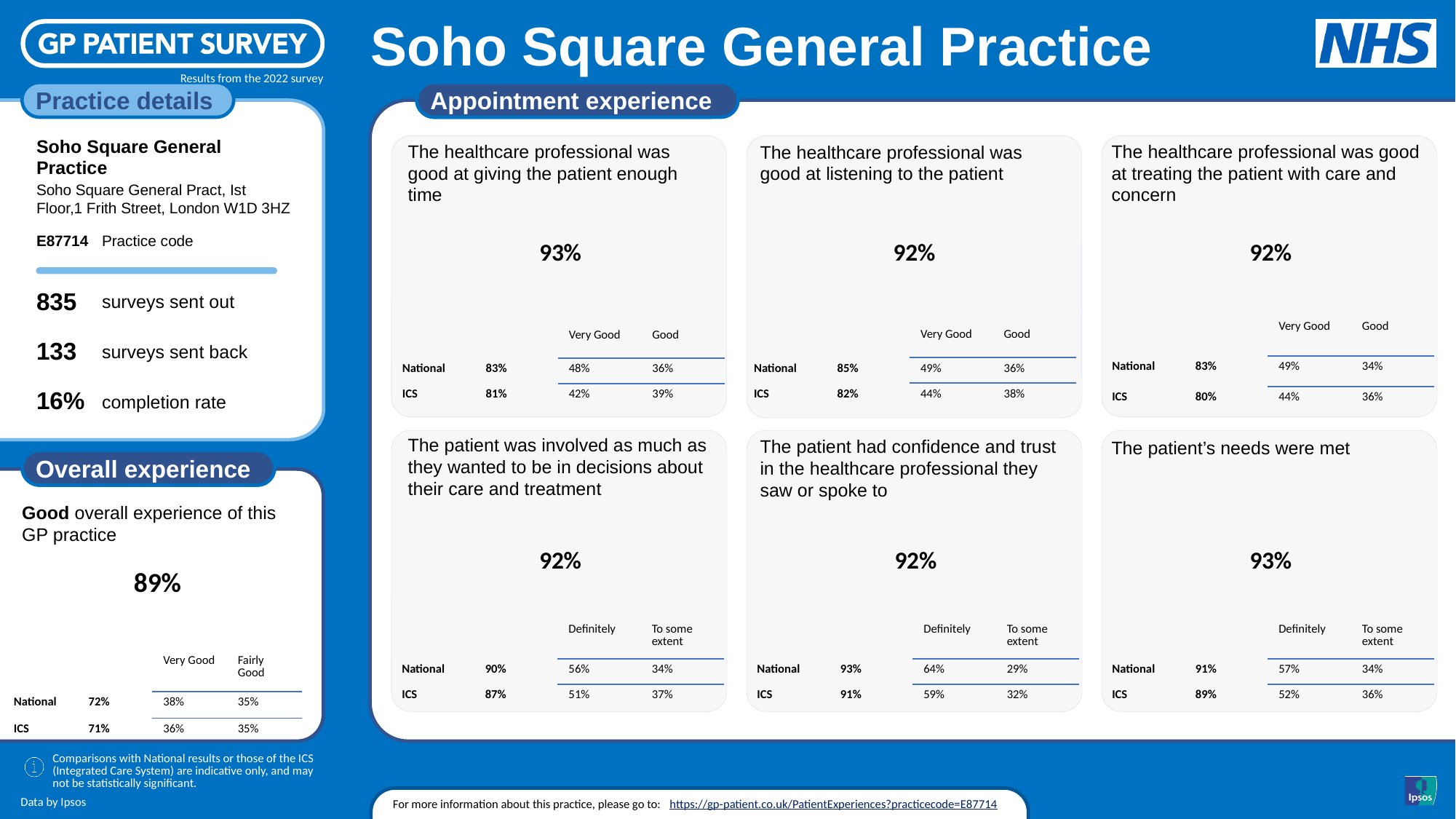
In the 'Overall experience' panel, what percentage of patients reported a good overall experience of this GP practice? 89% In the panel 'The patient's needs were met', what is the difference between the National figure (91%) and the ICS figure (89%)? 2 percentage points In the panel 'The healthcare professional was good at treating the patient with care and concern', what is the ICS overall figure? 80% In the panel 'The patient had confidence and trust in the healthcare professional they saw or spoke to', which is larger: the National 'Definitely' percentage or the ICS 'Definitely' percentage? National (64%) In the panel 'The patient was involved as much as they wanted to be in decisions about their care and treatment', what is the difference between the practice's 92% and the National 90%? 2 percentage points In the panel 'The healthcare professional was good at giving the patient enough time', what is the practice's headline percentage? 93% How many question panels are shown under the 'Appointment experience' heading? 6 In the panel 'The healthcare professional was good at listening to the patient', what is the National 'Very Good' percentage? 49% In the panel 'The patient's needs were met', what is the ICS 'To some extent' percentage? 36% In the 'Overall experience' panel, what is the ICS 'Very Good' percentage? 36% In the 'Overall experience' panel, what is the National figure for good overall experience? 72% In the panel 'The healthcare professional was good at giving the patient enough time', what is the ICS 'Good' percentage? 39%